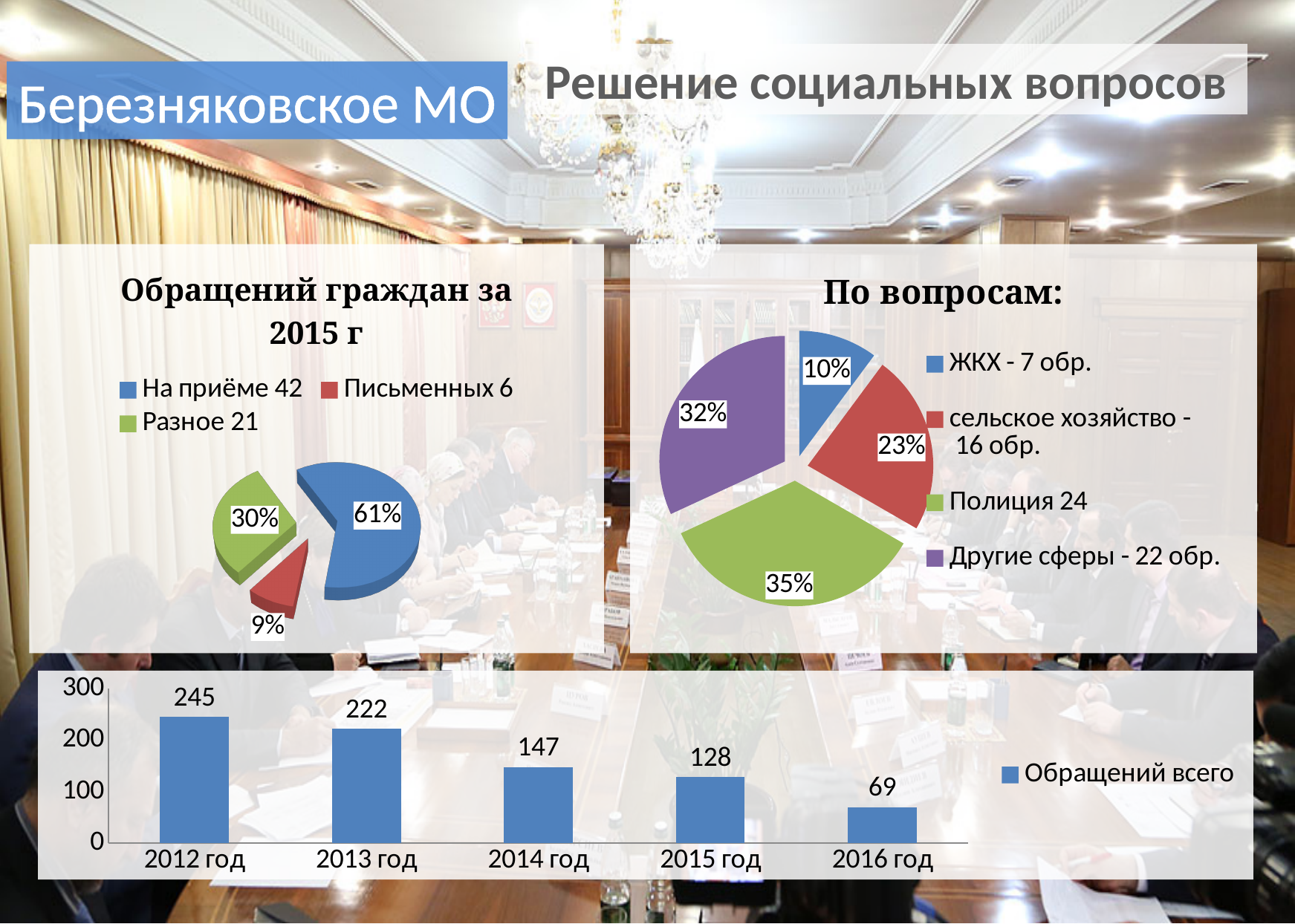
In the pie chart 'Обращений граждан за 2015 г', what share does 'На приёме 42' have? 61% In the bottom bar chart, which year has the highest value? 2012 год What kind of chart is the chart at the bottom of the slide? bar chart How many entries does the legend of the pie chart 'По вопросам:' list? 4 In the bottom bar chart, which year has the lowest value? 2016 год In the pie chart 'Обращений граждан за 2015 г', what share does 'Письменных 6' have? 9% How many bars are in the bottom bar chart? 5 In the bottom bar chart, do the values rise or fall from 2012 год to 2016 год? fall In the bottom bar chart, what is the difference between the values for 2013 год and 2014 год? 75 In the bottom bar chart, what is the value for 2012 год? 245 In the pie chart 'По вопросам:', what share does 'Полиция 24' have? 35% In the bottom bar chart, what is the value for 2016 год? 69